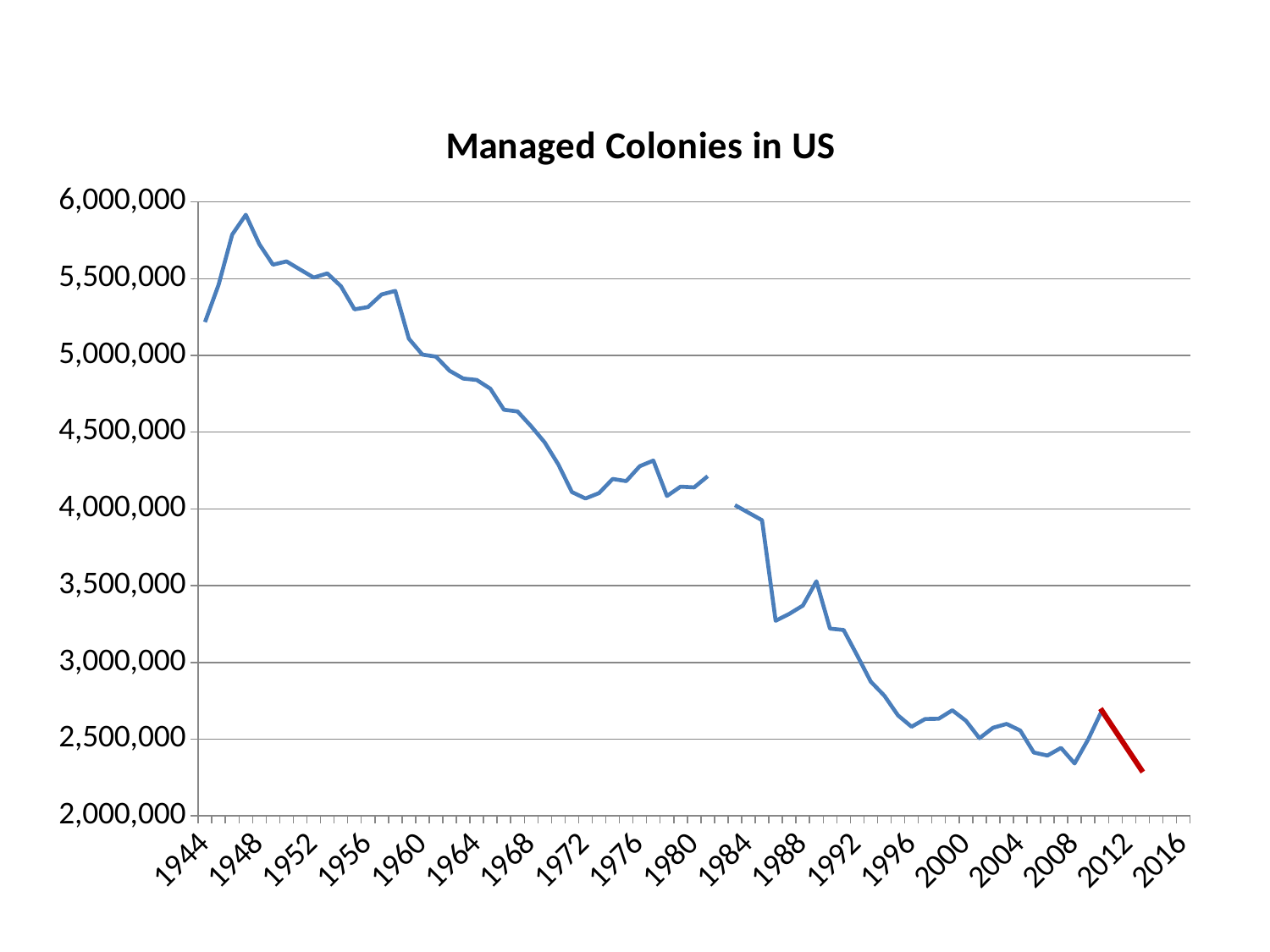
Which year has the larger value, 1960 or 1980? 1960 Is the value for 1948 greater or less than 5,500,000? greater Which year has the larger value, 1944 or 2008? 1944 Is the value for 2008 greater or less than 2,500,000? less Is the value for 1972 greater or less than 4,000,000? greater What is the title of the chart? Managed Colonies in US What colour is the final segment of the line, after 2012? red What kind of chart is shown on the slide? line chart Do the values generally rise or fall from 1944 to 2012? fall